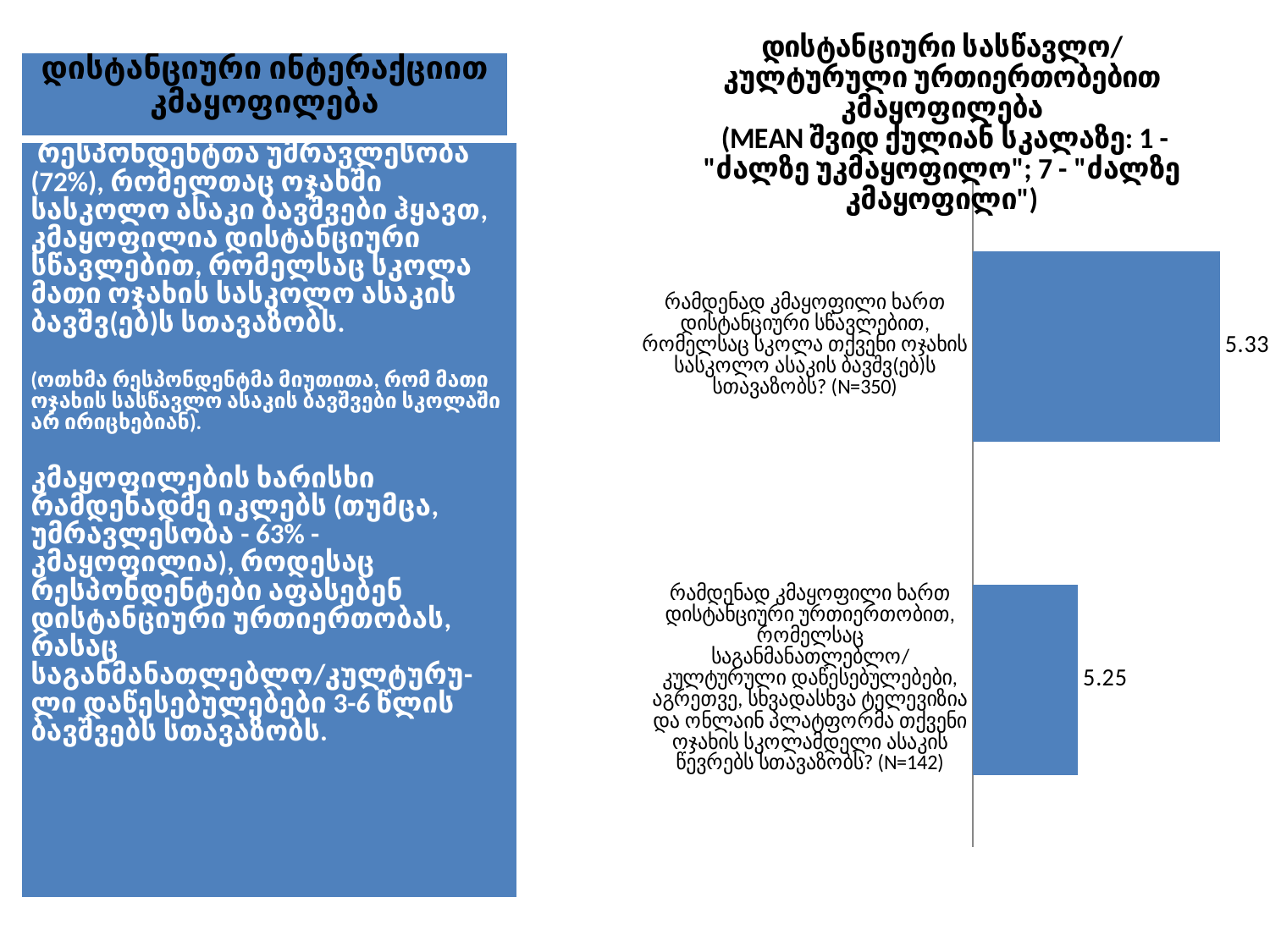
What is the value of the bottom bar (the question about distance interaction with educational/cultural institutions, N=142)? 5.25 What type of chart is shown on the slide? Bar chart What is the sample size (N) for the bottom bar? 142 What is the sample size (N) for the top bar? 350 Is the value for the N=350 question larger or smaller than the value for the N=142 question? Larger What is the difference between the values of the top bar (5.33) and the bottom bar (5.25)? 0.08 Which bar has the higher value, the top one (N=350) or the bottom one (N=142)? The top one (N=350) How many bars are plotted in the chart? 2 What is the value of the top bar (the question about distance learning, N=350)? 5.33 Which bar has the lower value, the top one (N=350) or the bottom one (N=142)? The bottom one (N=142)